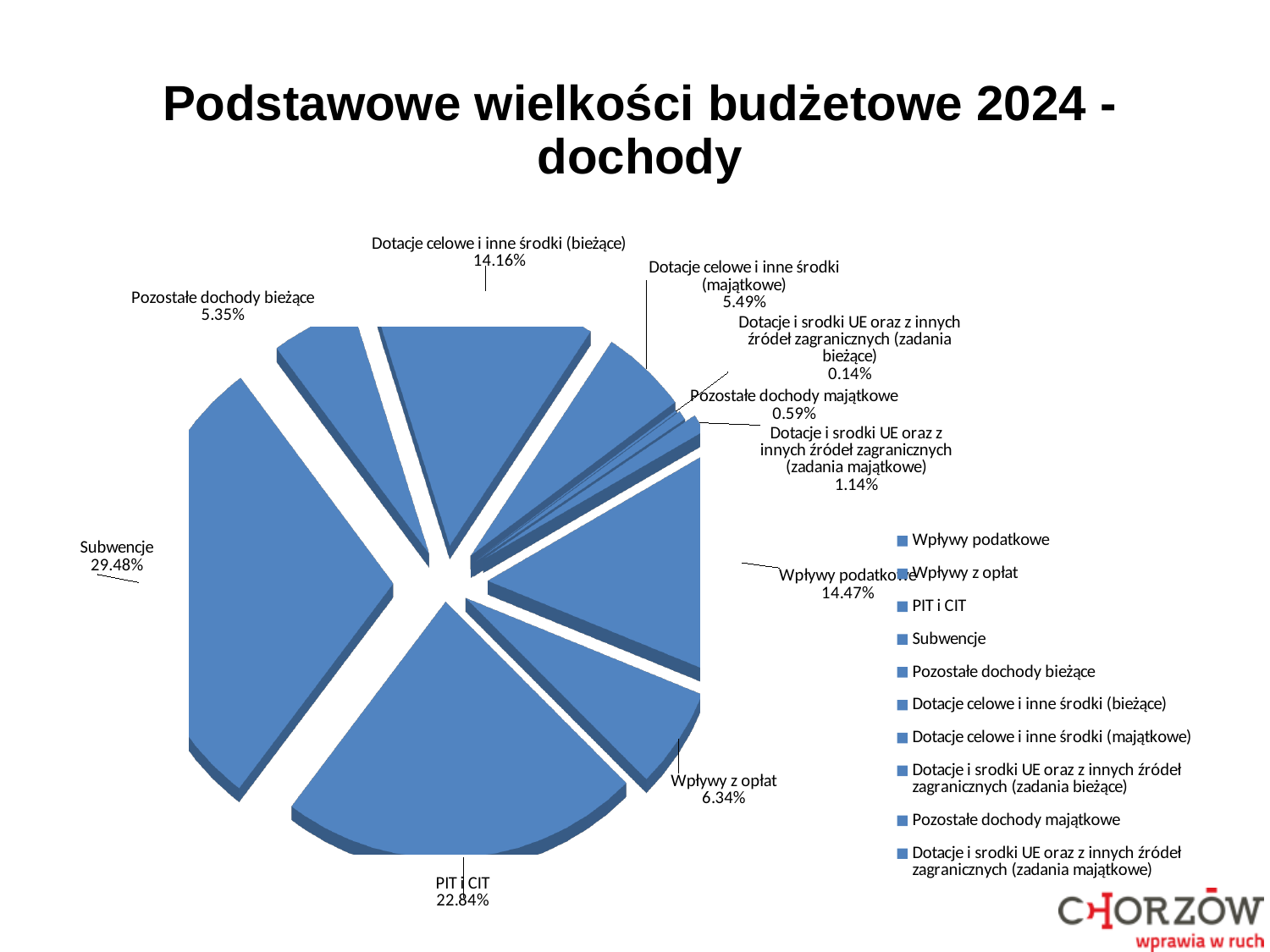
What share of the pie does Subwencje represent? 29.48% Which is larger, Wpływy podatkowe or Dotacje celowe i inne środki (bieżące)? Wpływy podatkowe Which category has the largest share of the pie? Subwencje How many slices does the pie chart have? 10 What is the difference in percentage points between Subwencje and PIT i CIT? 6.64 What type of chart is shown on the slide? Pie chart What is the title of the slide? Podstawowe wielkości budżetowe 2024 - dochody How many entries does the legend list? 10 What percentage is labelled for Wpływy z opłat? 6.34% What is the value shown for PIT i CIT? 22.84% Which category has the smallest share of the pie? Dotacje i środki UE oraz z innych źródeł zagranicznych (zadania bieżące) What is the value for Dotacje celowe i inne środki (majątkowe)? 5.49%